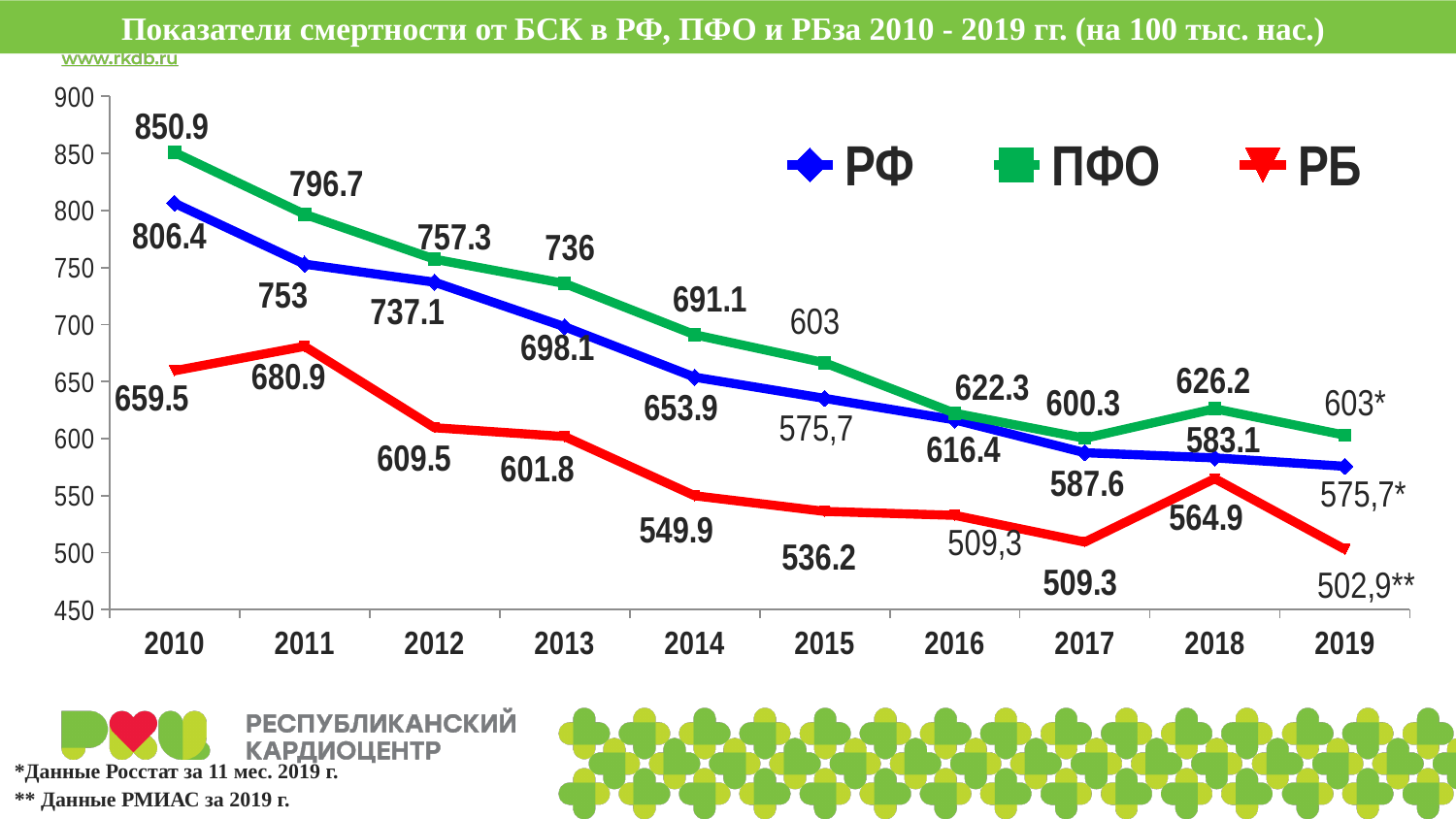
What is the value for РБ in 2014? 549.9 What is the value for РФ in 2013? 698.1 How many years are shown on the x axis? 10 How many series does the legend list? 3 What is the difference between the ПФО and РФ values in 2010? 44.5 What is the value for ПФО in 2010? 850.9 What kind of chart is shown on the slide? line chart Does the РФ series rise or fall from 2010 to 2019? fall In which year does the РБ series reach its highest value? 2011 Which series has the highest value in 2010? ПФО Which is larger in 2018, the value for РФ or the value for ПФО? ПФО What is the value for РБ in 2017? 509.3